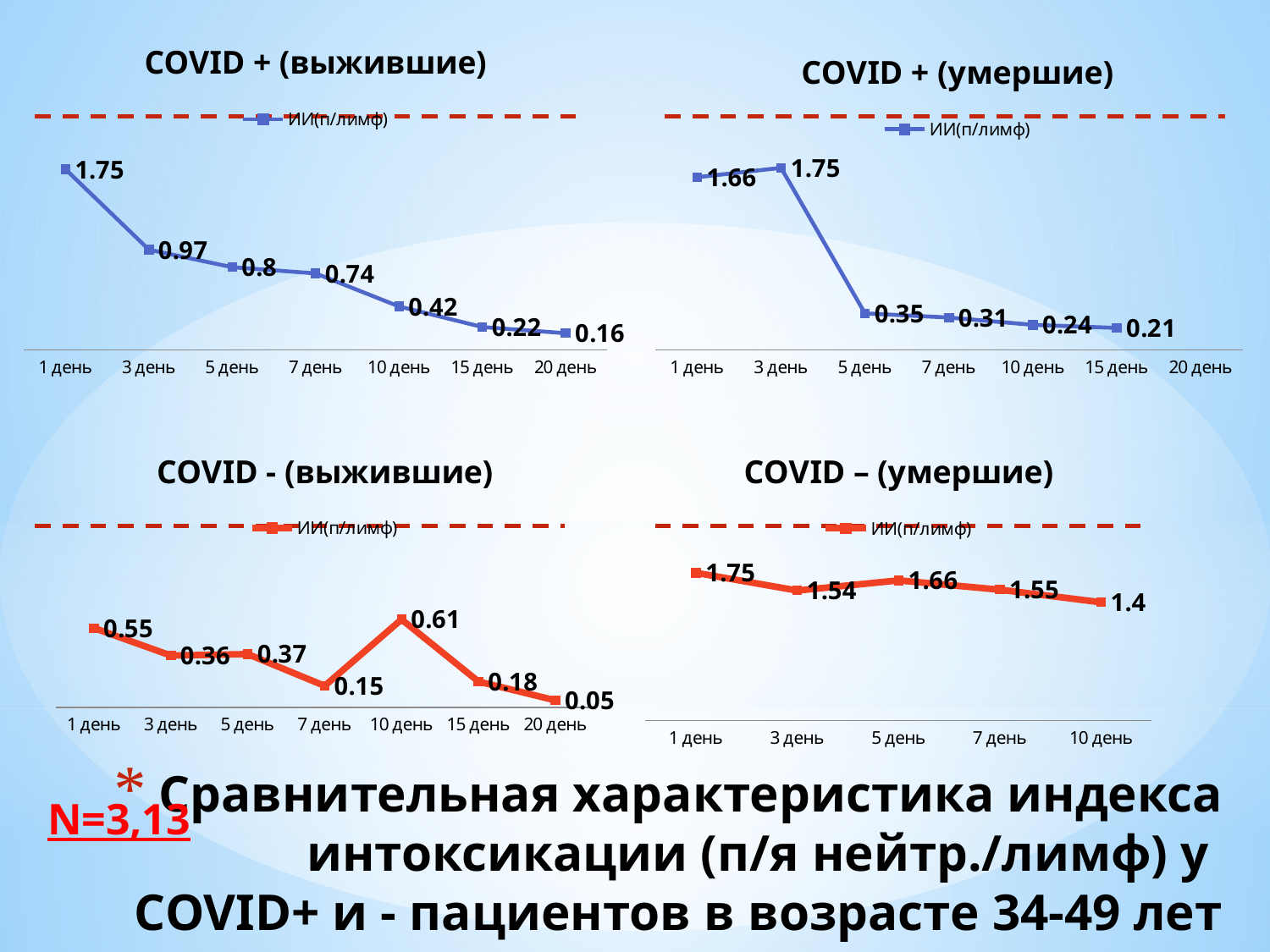
In the chart titled "COVID + (умершие)", which is larger: the value on 1 день or on 3 день? 3 день In the chart titled "COVID + (выжившие)", what is the value on 20 день? 0.16 In the chart titled "COVID - (выжившие)", on which day is the value lowest? 20 день In the chart titled "COVID - (выжившие)", on which day is the value highest? 10 день In the chart titled "COVID – (умершие)", what is the value on 10 день? 1.4 In the chart titled "COVID - (выжившие)", what is the value on 7 день? 0.15 What kind of chart is the chart titled "COVID + (выжившие)"? Line chart In the chart titled "COVID + (умершие)", what is the value on 5 день? 0.35 In the chart titled "COVID + (выжившие)", what is the difference between the values on 1 день and 10 день? 1.33 In the chart titled "COVID – (умершие)", how many data points are plotted? 5 In the chart titled "COVID + (умершие)", on which day is the value highest? 3 день In the chart titled "COVID + (выжившие)", what is the value on 3 день? 0.97